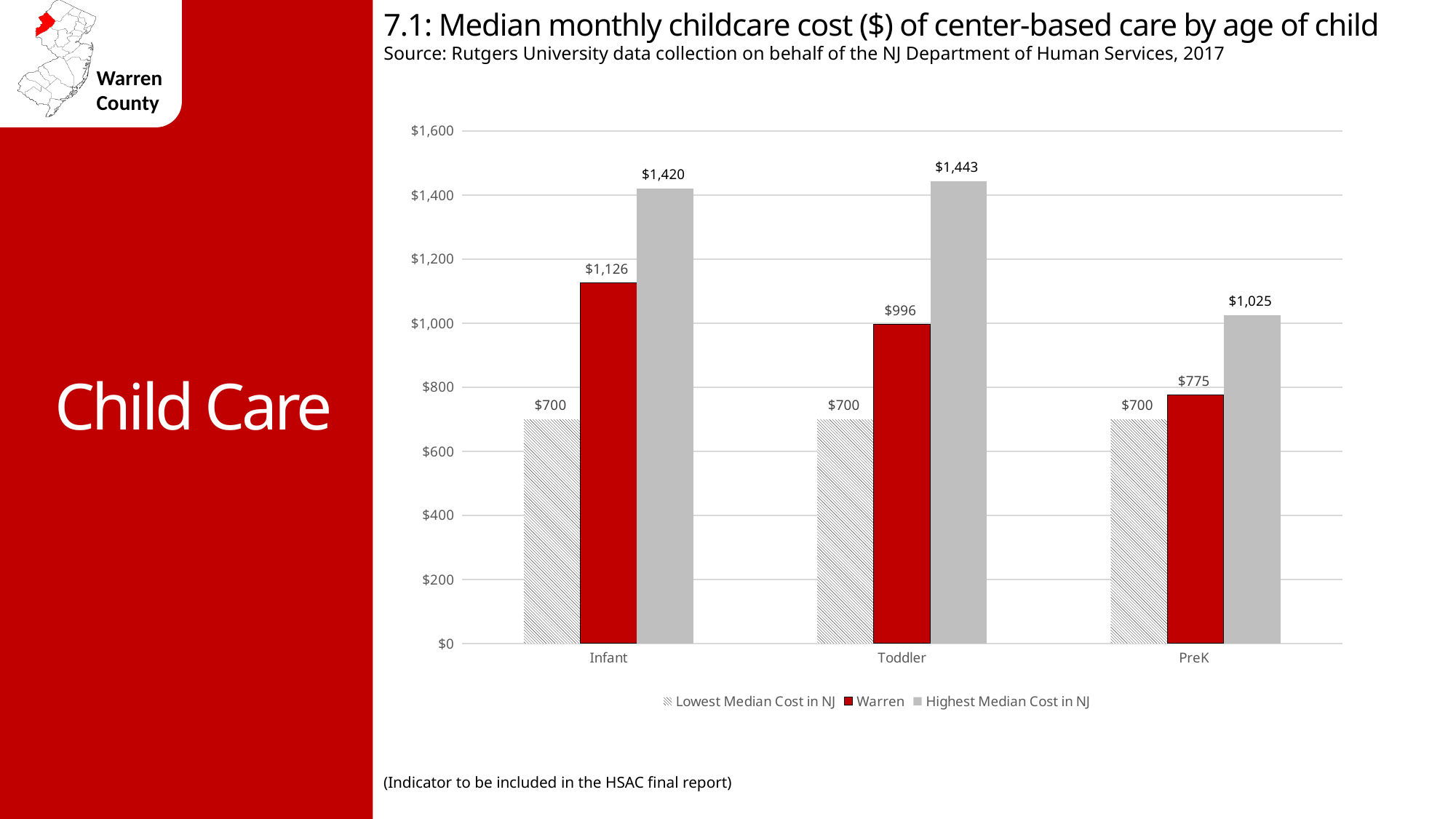
What is the Lowest Median Cost in NJ for PreK care? $700 What is the Warren median monthly childcare cost for Infant care? $1,126 For which age group is the Highest Median Cost in NJ lowest? PreK Which is larger for Toddler care: the Warren cost or the Lowest Median Cost in NJ? Warren For which age group is the Warren median monthly cost highest? Infant What kind of chart is shown on the slide? Bar chart Which series is drawn in red? Warren How many age groups are shown on the x axis? 3 Is the Warren value for Toddler care greater or less than $1,000? less What is the Highest Median Cost in NJ for Toddler care? $1,443 What is the difference between the Highest Median Cost in NJ and the Warren cost for PreK care? $250 How many series does the legend list? 3